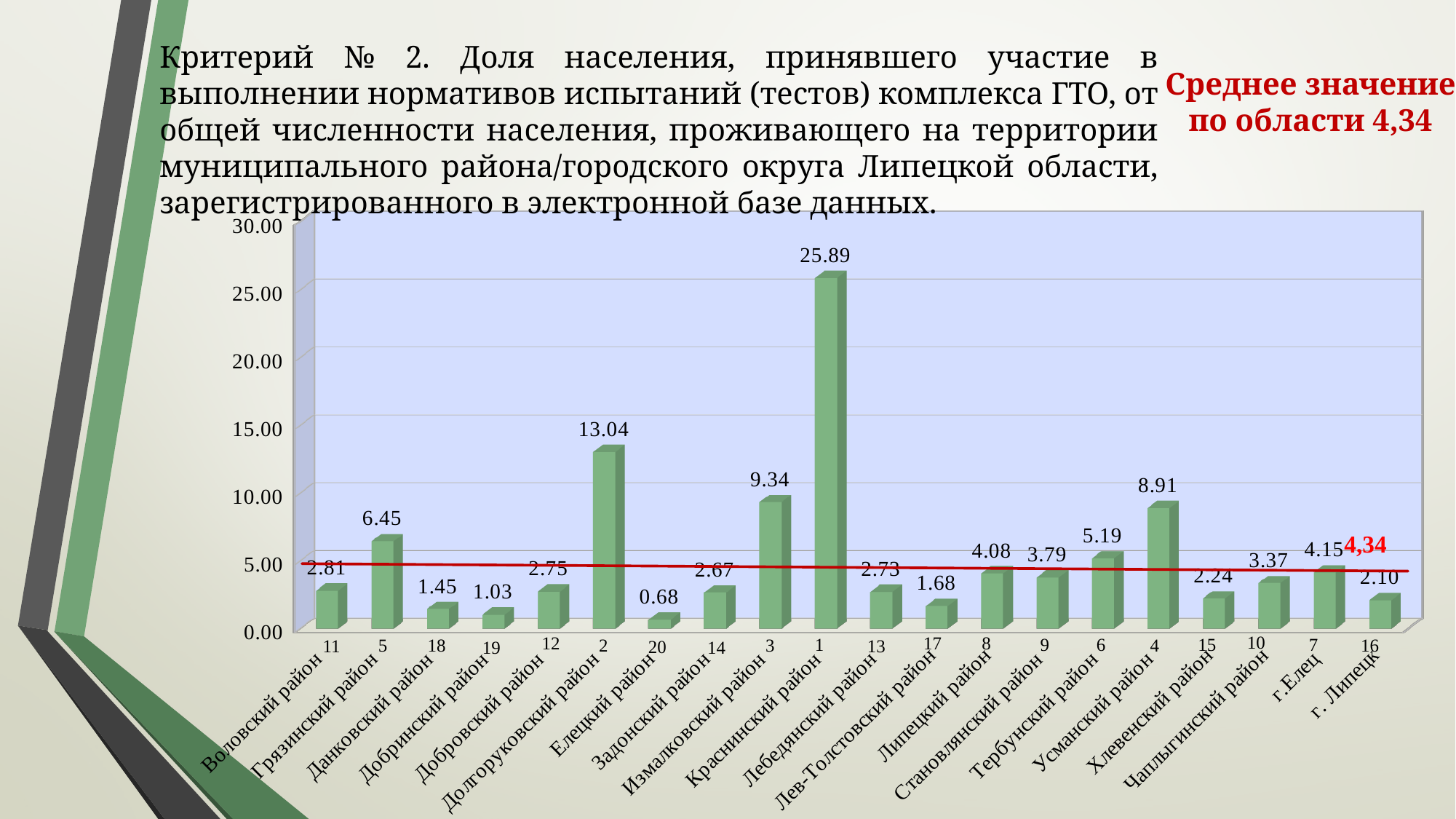
What is the difference between the values for Измалковский район and Усманский район? 0.43 What is the average value for the region shown by the red line? 4,34 What kind of chart is shown on the slide? bar chart What is the value for Краснинский район? 25.89 Is the value for Долгоруковский район greater or less than 10.00? greater Which is larger, the value for Грязинский район or the value for Тербунский район? Грязинский район What rank number is shown above Усманский район? 4 Which district has the lowest value? Елецкий район What is the value for Долгоруковский район? 13.04 What is the value for г. Липецк? 2.10 Which district has the highest value? Краснинский район How many districts/cities are shown on the chart? 20